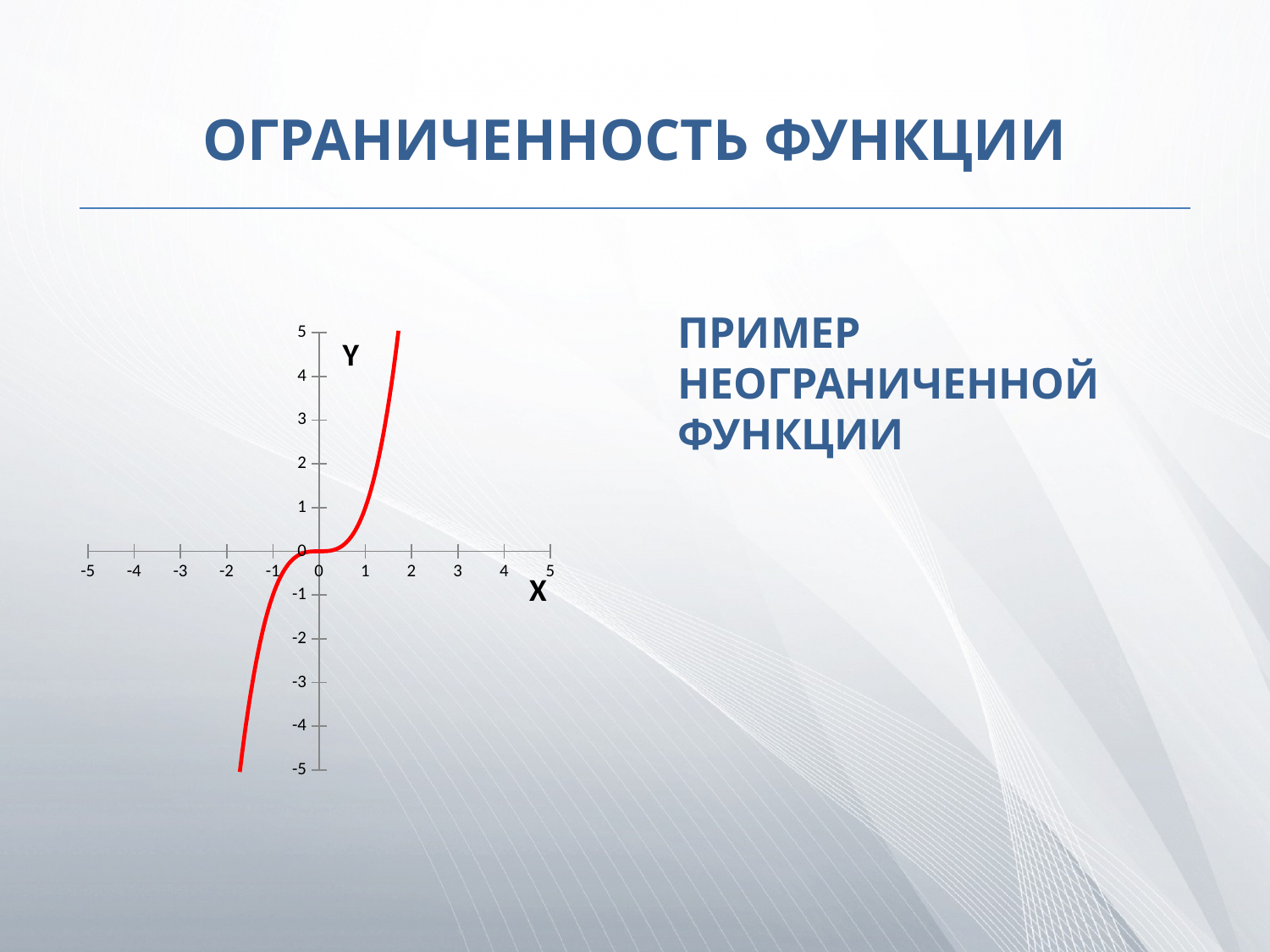
Does the plotted curve rise or fall as x increases? rises Is the value of the function at x = 1 greater or less than 2? less What colour is the plotted curve? red Is the value of the function at x = 1.5 greater or less than 2? greater What is the value of the function at x = 0? 0 How many curves are plotted on the chart? 1 What is the highest value labelled on the vertical axis? 5 What kind of chart is shown on the slide? line chart Is the value of the function at x = -1 greater or less than -2? greater